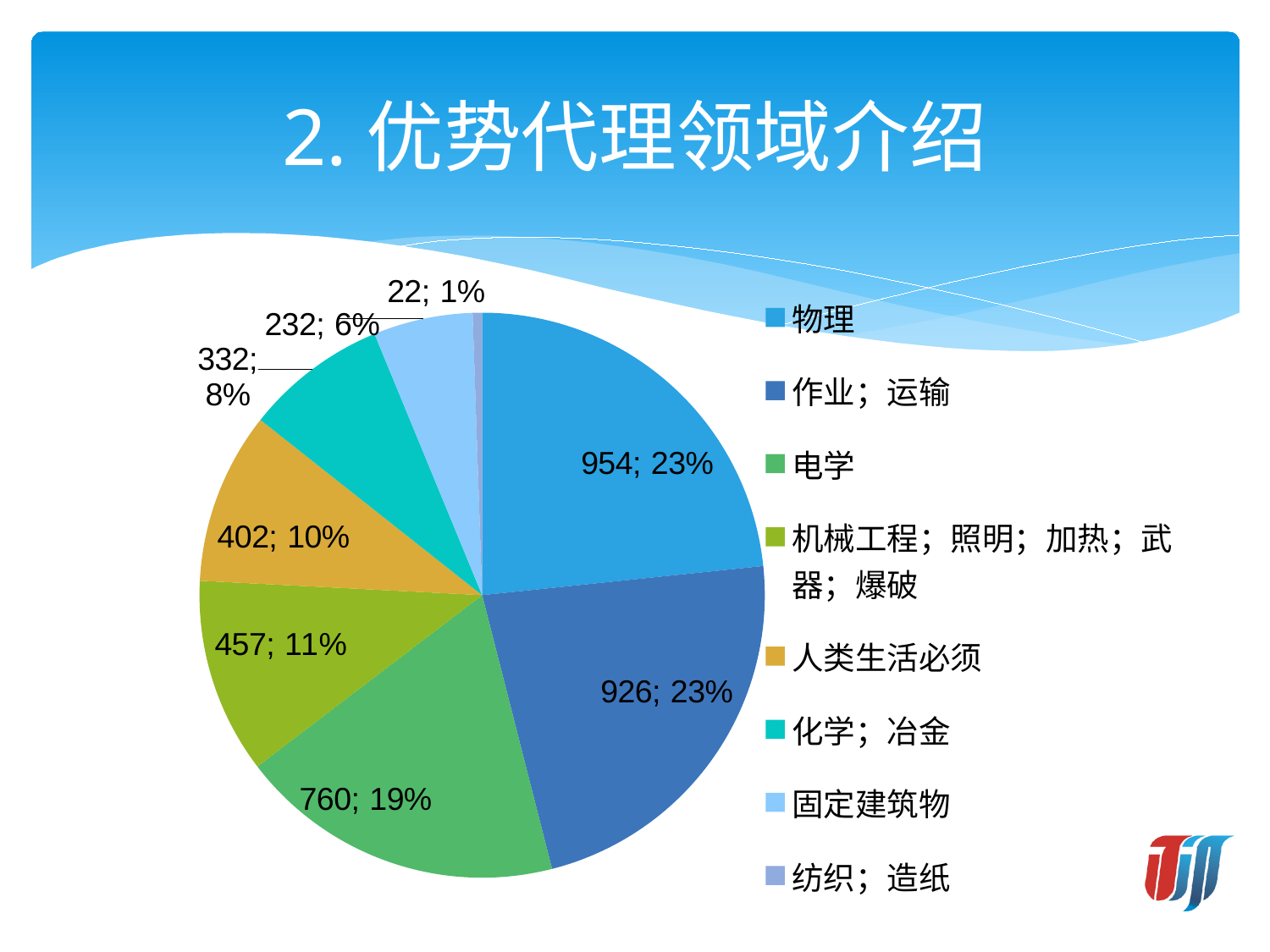
What is the value shown for 人类生活必须? 402 Which category has the smallest slice in the pie chart? 纺织；造纸 What is the title of the slide containing the pie chart? 2. 优势代理领域介绍 Which is larger, the value for 机械工程；照明；加热；武器；爆破 or the value for 人类生活必须? 机械工程；照明；加热；武器；爆破 What percentage share does 电学 have in the pie chart? 19% What kind of chart is shown on the slide? pie chart What is the value shown for 物理 in the pie chart? 954 What percentage share does 化学；冶金 have? 8% How many slices does the pie chart have? 8 Which category has the largest value in the pie chart? 物理 What is the value shown for 固定建筑物? 232 What is the difference between the values for 物理 and 作业；运输? 28